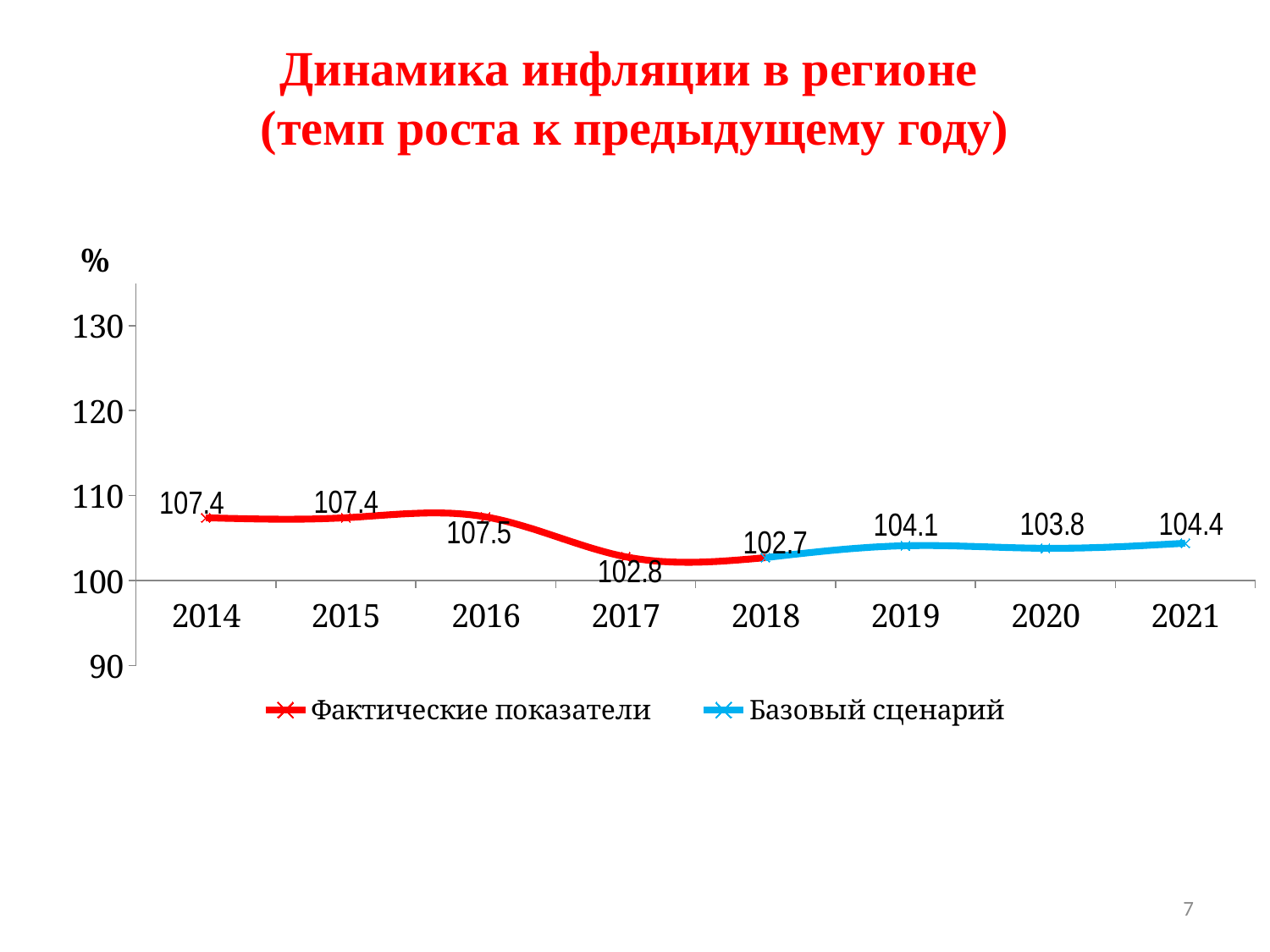
Which year has the lowest value in the chart? 2018 Which series is drawn in blue according to the legend? Базовый сценарий How many years are shown on the x axis? 8 Which year has the highest value in the chart? 2016 What is the difference between the values for 2016 and 2017? 4.7 What is the value for 2016 in the chart? 107.5 What is the value for 2019 in the chart? 104.1 Which is larger, the value for 2019 or the value for 2020? 2019 What type of chart is shown on the slide? line chart What is the value for 2021 in the chart? 104.4 How many series does the legend list? 2 What is the value for 2017 in the chart? 102.8